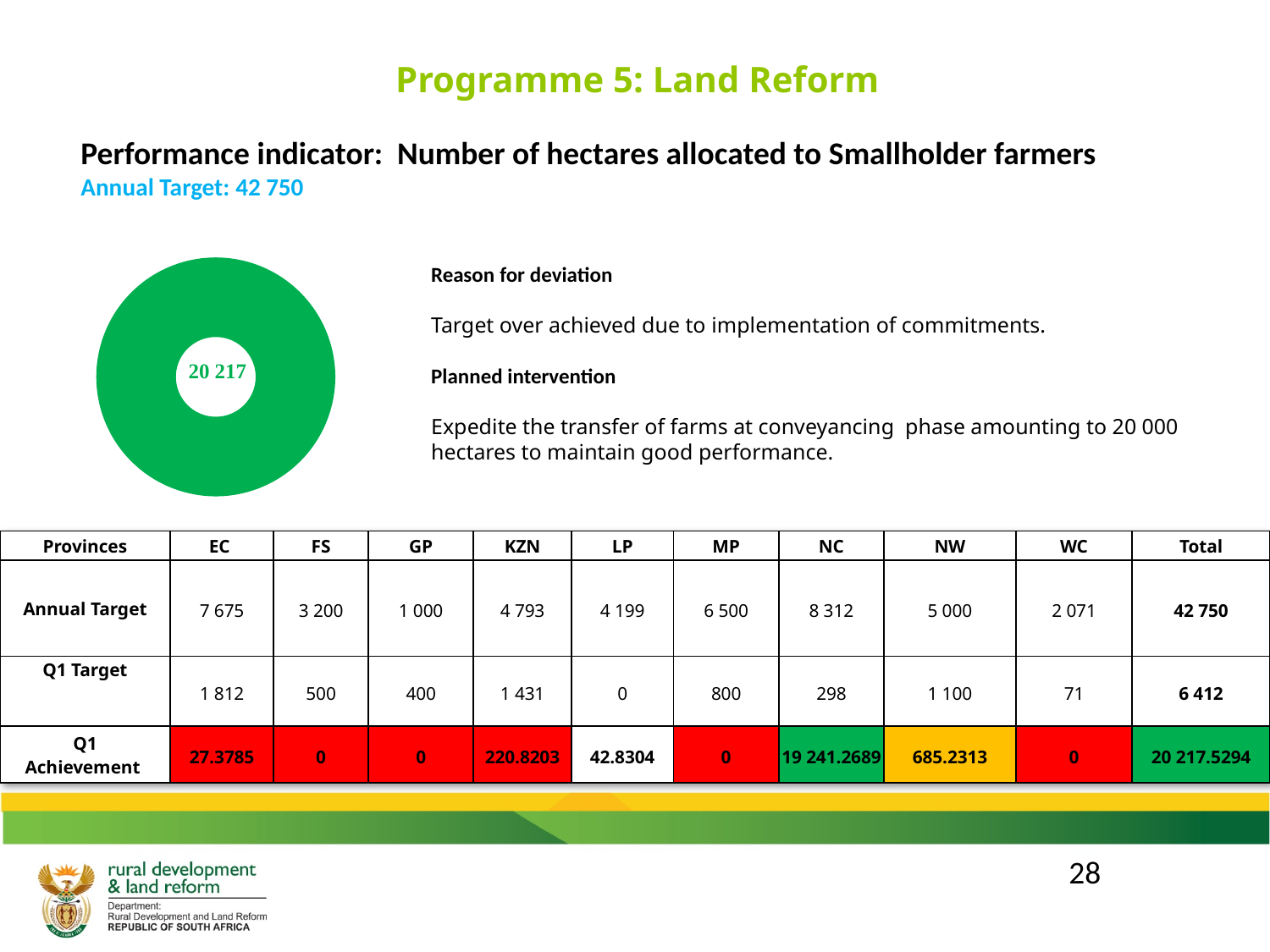
Does the doughnut chart display a legend? No What colour is the ring of the doughnut chart? Green How many distinct slices are visible in the doughnut chart? 1 What kind of chart is shown on the left of the slide? Doughnut chart What value is printed in the centre of the doughnut chart? 20 217